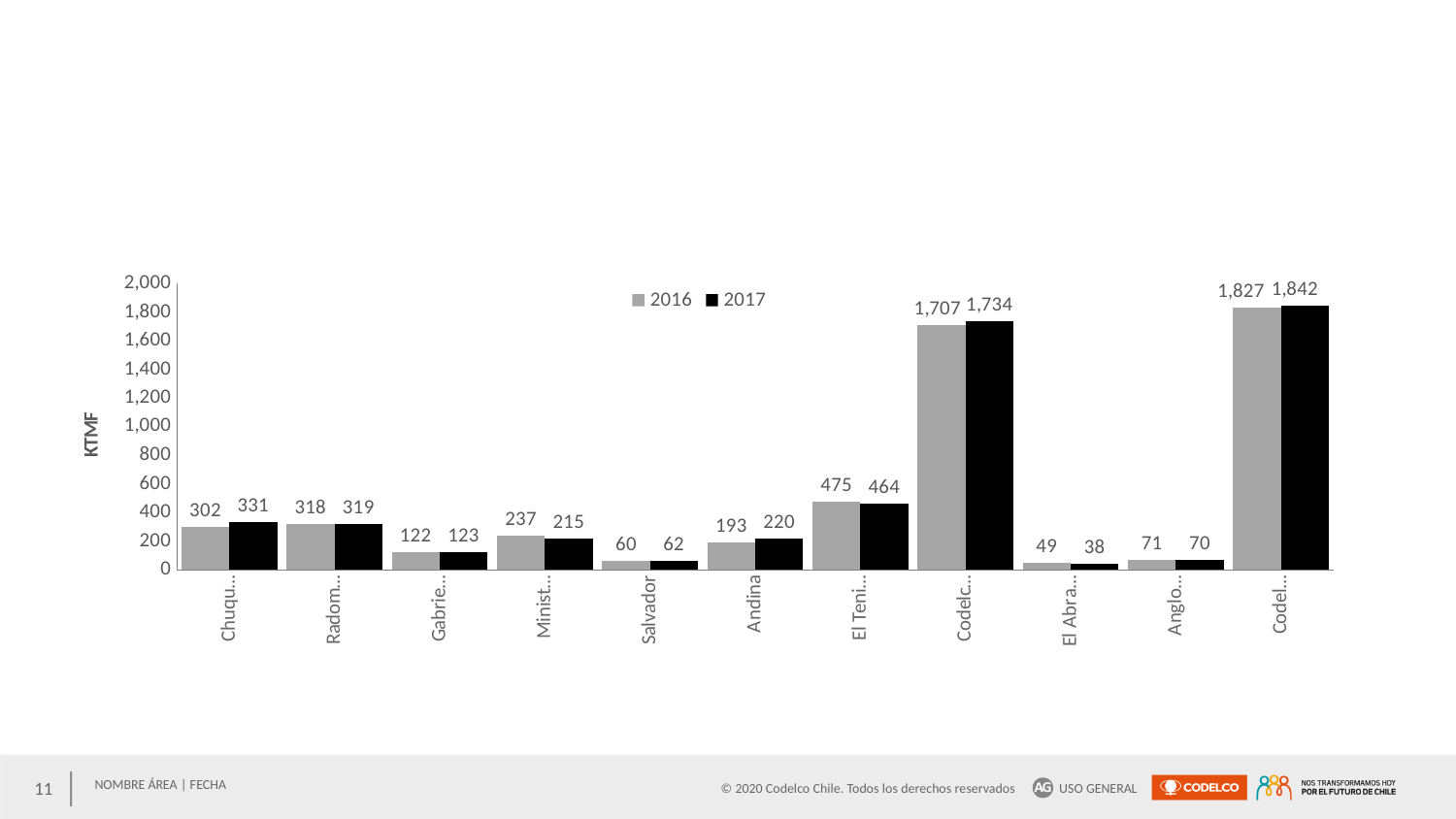
What is the lowest 2017 value shown on the chart? 38 Which has the larger 2016 value, Andina or Salvador? Andina What is the highest 2017 value shown on the chart? 1,842 What is the 2017 value for Andina? 220 What kind of chart is shown on the slide? bar chart Is the 2017 value for Salvador greater or less than 200? less How many series does the legend list? 2 What is the label on the y axis? KTMF How many categories are shown on the x axis? 11 What is the 2016 value for the category labelled "El Abra..."? 49 By how much did the value for Andina increase from 2016 to 2017? 27 What is the 2016 value for Salvador? 60